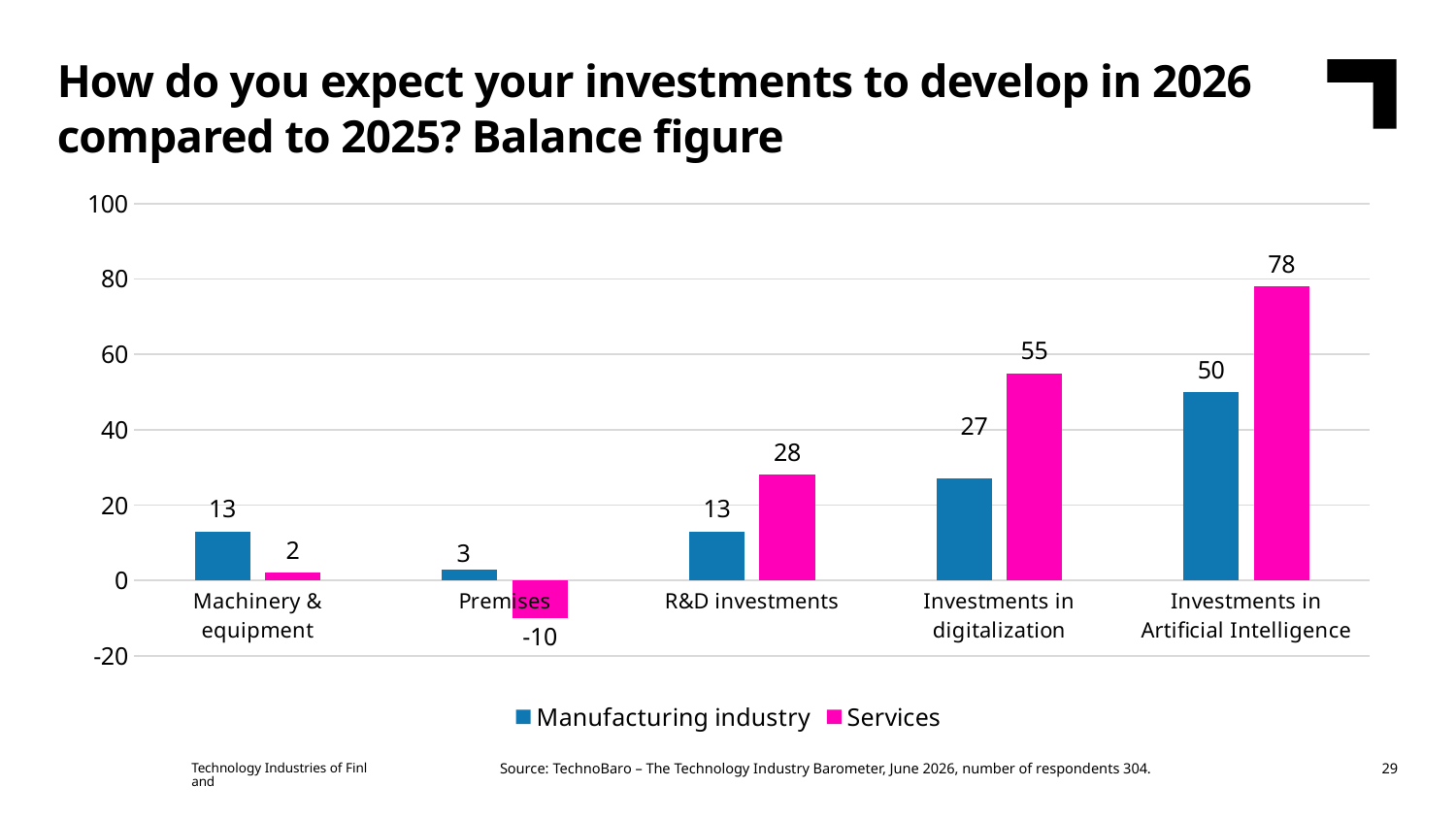
What is the value for Services in the Premises category? -10 Which category has the lowest value for Manufacturing industry? Premises What is the difference between the Services and Manufacturing industry values for R&D investments? 15 Is the value for Services in Investments in Artificial Intelligence greater or less than 60? greater Which category has the highest value for Services? Investments in Artificial Intelligence How many categories are shown on the x axis? 5 What kind of chart is shown on the slide? Bar chart How many series does the legend list? 2 Which colour represents the Services series? Pink Which is larger for Machinery & equipment: Manufacturing industry or Services? Manufacturing industry What is the value for Manufacturing industry in the Investments in Artificial Intelligence category? 50 What is the value for Services in the Investments in digitalization category? 55